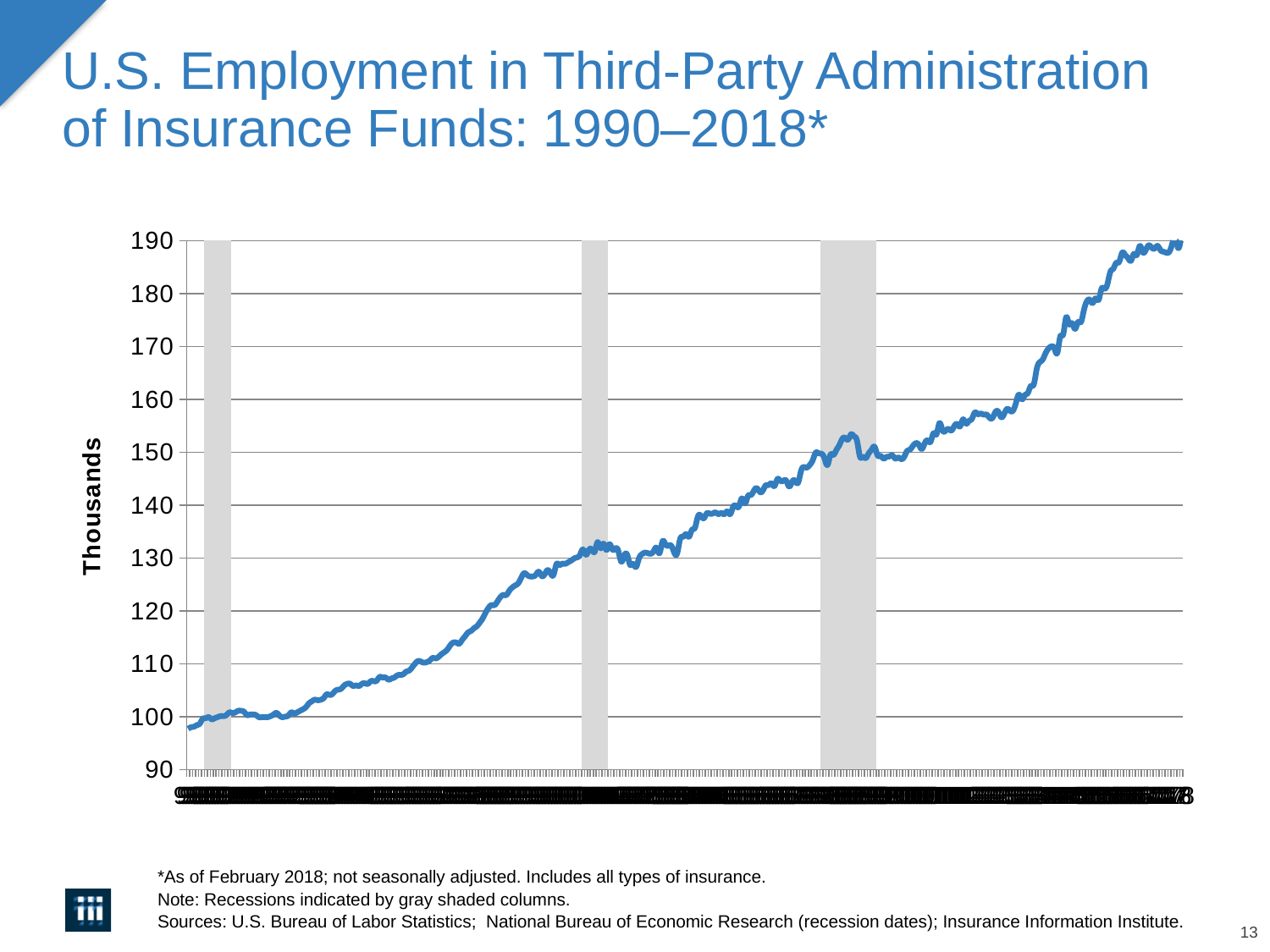
What kind of chart is shown on the slide? line chart Does employment generally rise or fall from the start of the series to the end? rise What do the gray shaded columns on the chart indicate? Recessions Is the value at the end of the series greater or less than the value at the start of the series? greater Is the lowest point on the line greater or less than 110? less Is the value at the end of the series (2018) greater or less than 180? greater Is the value at the start of the series (1990) greater or less than 110? less What is the label on the vertical axis? Thousands